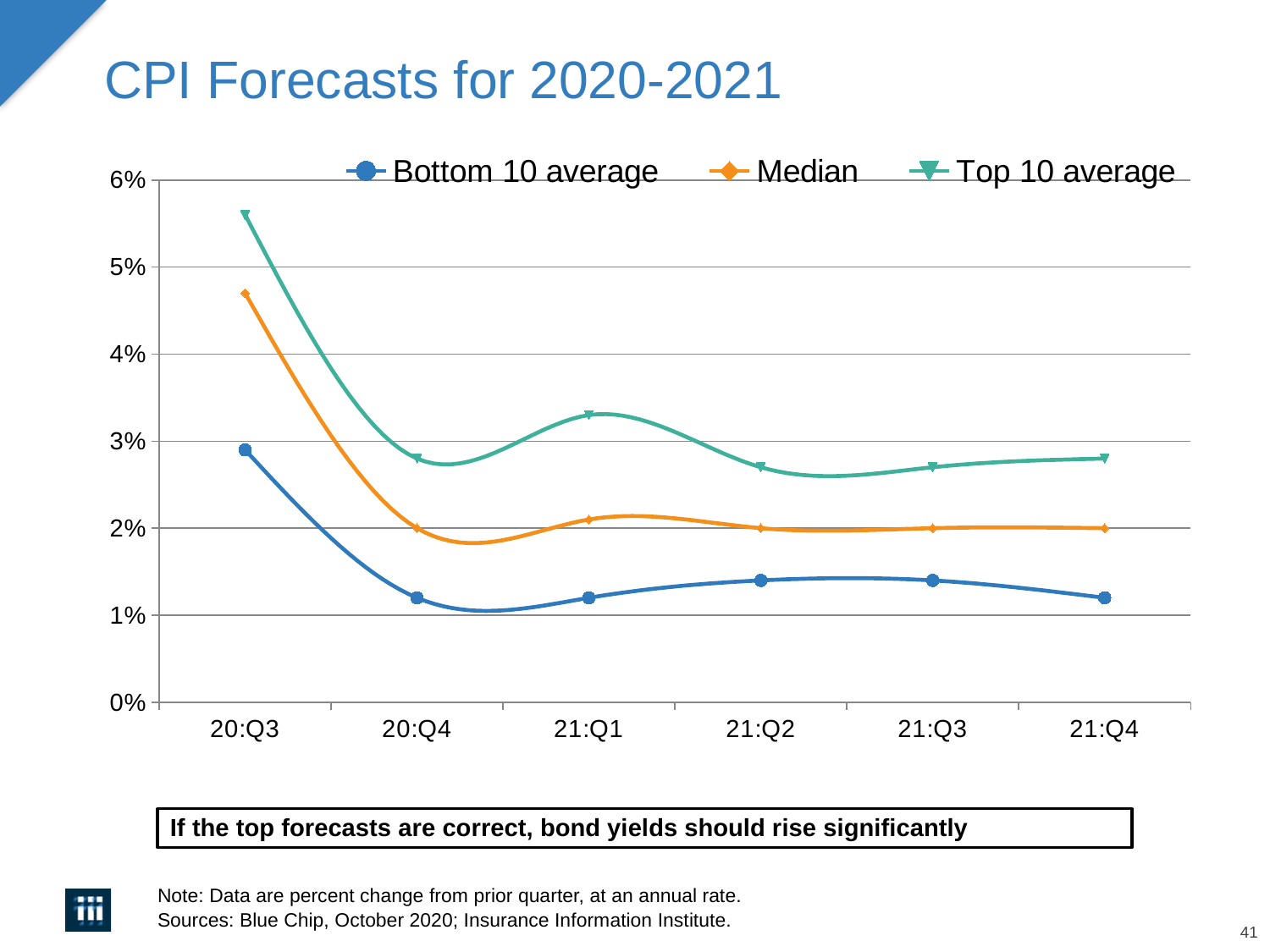
Is the Top 10 average value for 20:Q3 greater or less than 5%? greater In which quarter is the Top 10 average forecast highest? 20:Q3 Is the Bottom 10 average value for 20:Q4 greater or less than 2%? less Which series is shown with the orange line? Median What is the title of the chart? CPI Forecasts for 2020-2021 Is the Top 10 average value for 21:Q1 greater or less than 3%? greater How many series does the legend list? 3 Does the Top 10 average rise or fall from 20:Q3 to 20:Q4? fall Which is larger at 21:Q1, the Top 10 average or the Bottom 10 average? Top 10 average What kind of chart is shown on the slide? line chart How many quarters are plotted along the x axis? 6